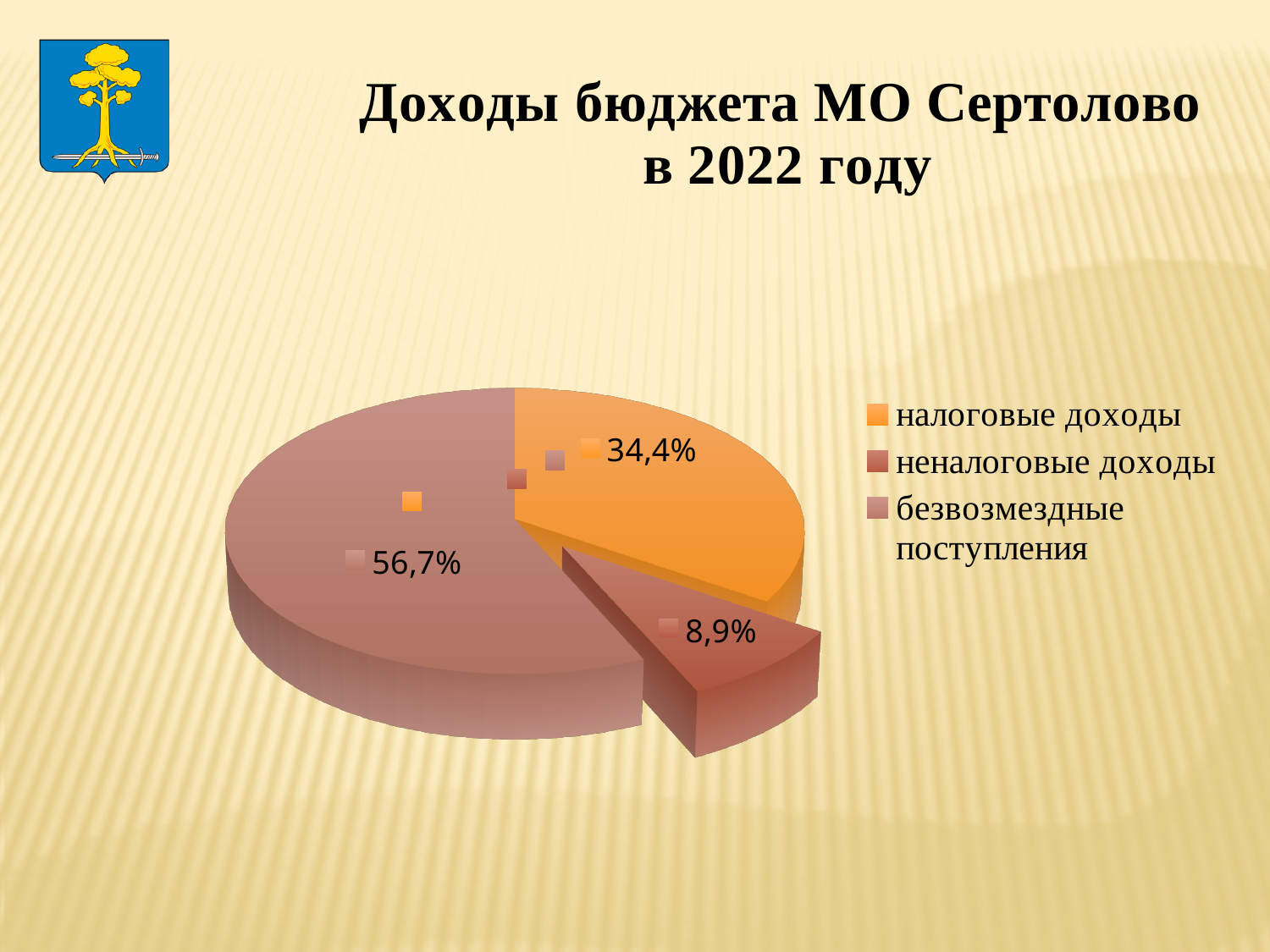
Which is larger: the share of "налоговые доходы" or the share of "неналоговые доходы"? налоговые доходы What is the difference between the shares of "безвозмездные поступления" and "налоговые доходы"? 22,3% What kind of chart is shown on the slide? pie chart Which category has the smallest share of the pie? неналоговые доходы How many categories does the pie chart have? 3 What share of the pie does "неналоговые доходы" represent? 8,9% What is the difference between the shares of "налоговые доходы" and "неналоговые доходы"? 25,5% What share of the pie does "налоговые доходы" represent? 34,4% What is the title of the slide containing the chart? Доходы бюджета МО Сертолово в 2022 году Which category has the largest share of the pie? безвозмездные поступления What colour is the slice for "налоговые доходы"? orange What share of the pie does "безвозмездные поступления" represent? 56,7%